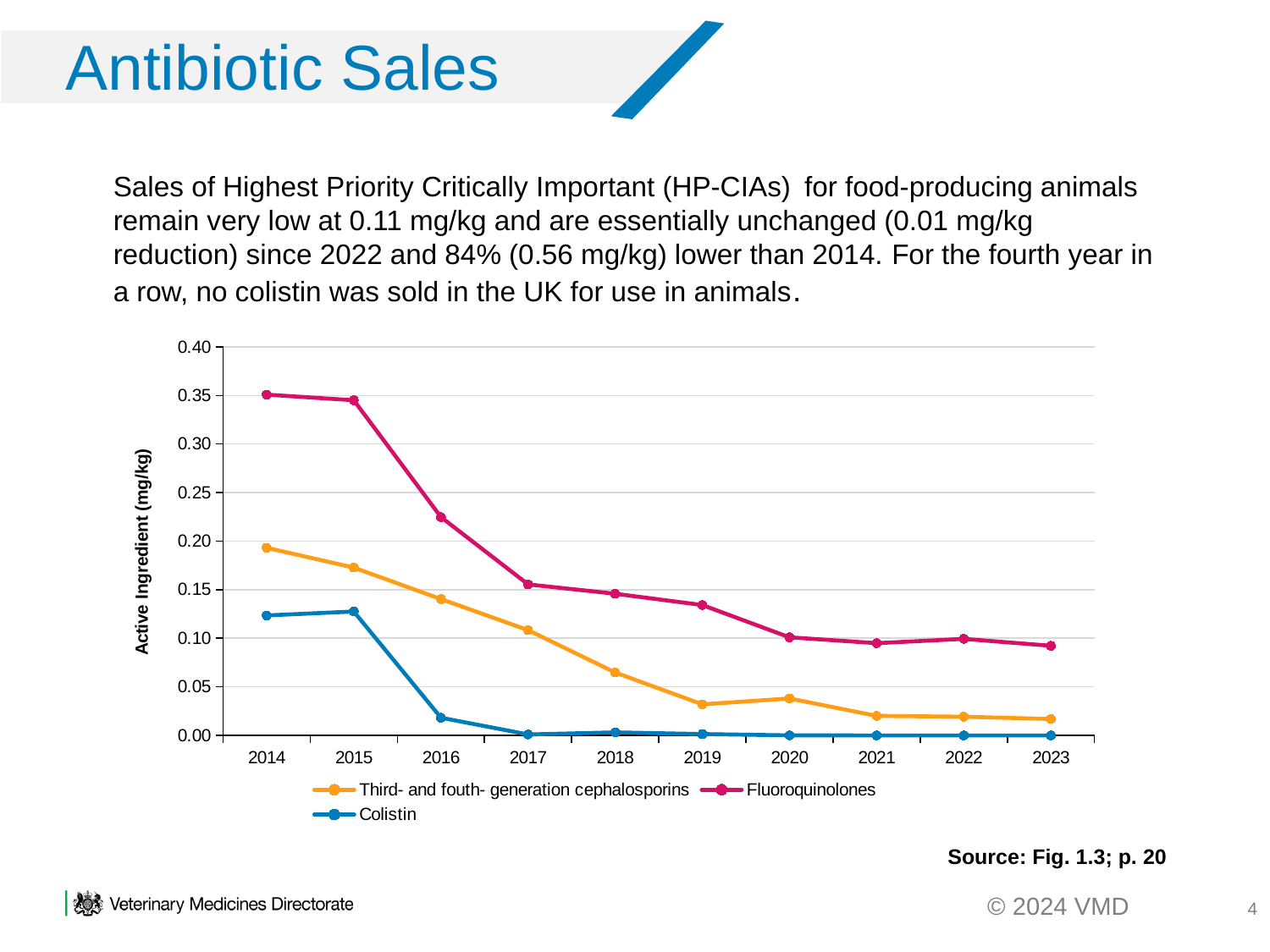
Is the value for Third- and fouth- generation cephalosporins in 2019 greater or less than 0.05? less Is the value for Fluoroquinolones in 2014 greater or less than 0.30? greater Which series has the highest value in 2014? Fluoroquinolones How many years are plotted along the x axis? 10 What is the label on the y axis? Active Ingredient (mg/kg) What is the value for Colistin in 2023? 0.00 Do the values for Fluoroquinolones generally rise or fall from 2014 to 2023? Fall What kind of chart is shown on the slide? Line chart Is the value for Colistin in 2016 greater or less than 0.05? less In 2015, which is larger: the value for Third- and fouth- generation cephalosporins or the value for Colistin? Third- and fouth- generation cephalosporins Which series has the lowest value in 2023? Colistin How many series does the legend list? 3